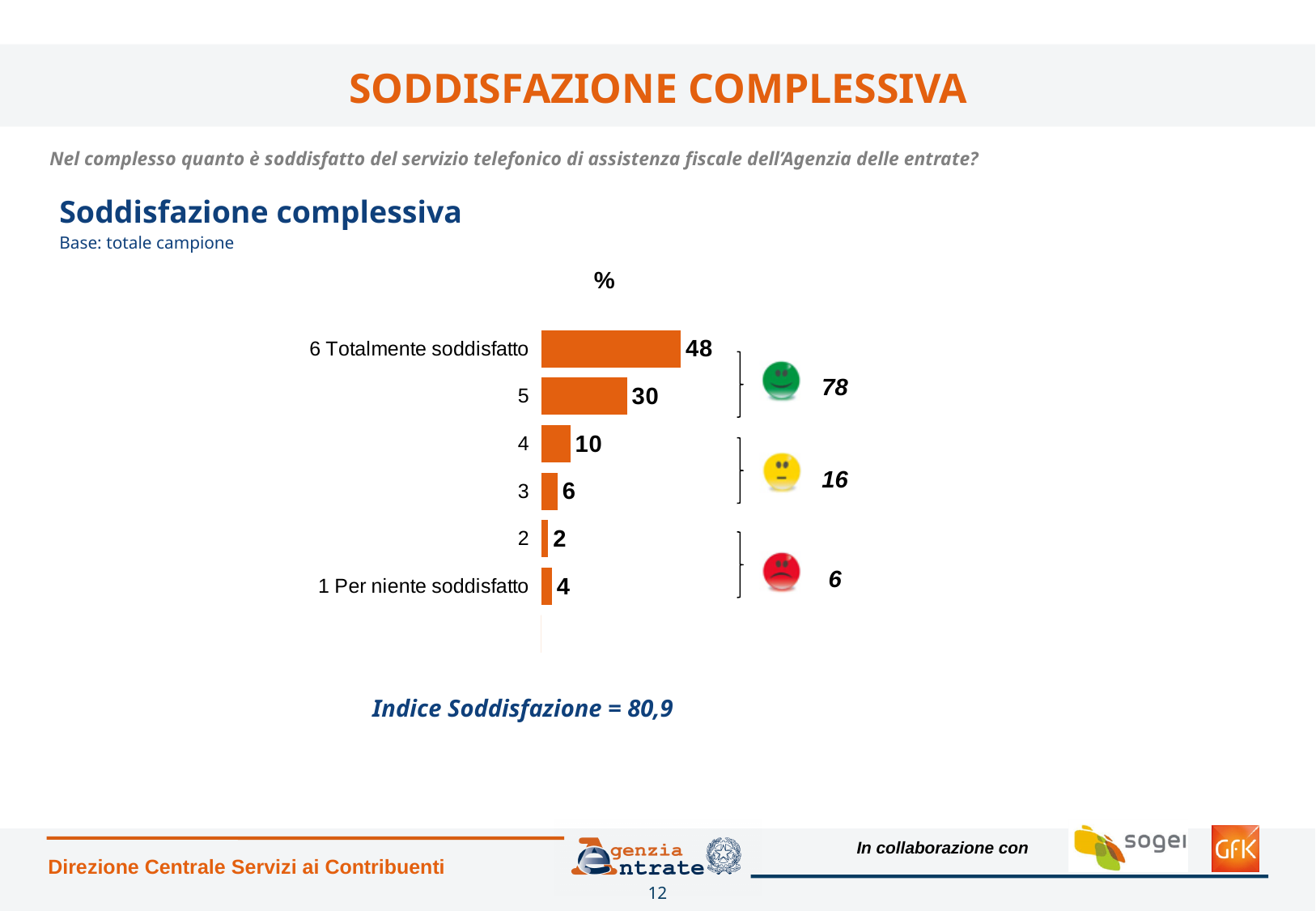
What is the value for "6 Totalmente soddisfatto"? 48 How many categories are shown in the chart? 6 Which is larger, the value for category 3 or the value for category 2? 3 What is the Indice Soddisfazione shown below the chart? 80,9 Which category has the lowest value? 2 What kind of chart is shown on the slide? bar chart What is the combined value shown next to the green smiley face for categories 6 and 5? 78 Which category has the highest value? 6 Totalmente soddisfatto What is the value for "1 Per niente soddisfatto"? 4 What is the value for category 4? 10 What is the value for category 5? 30 What is the difference between the values for category 6 and category 5? 18